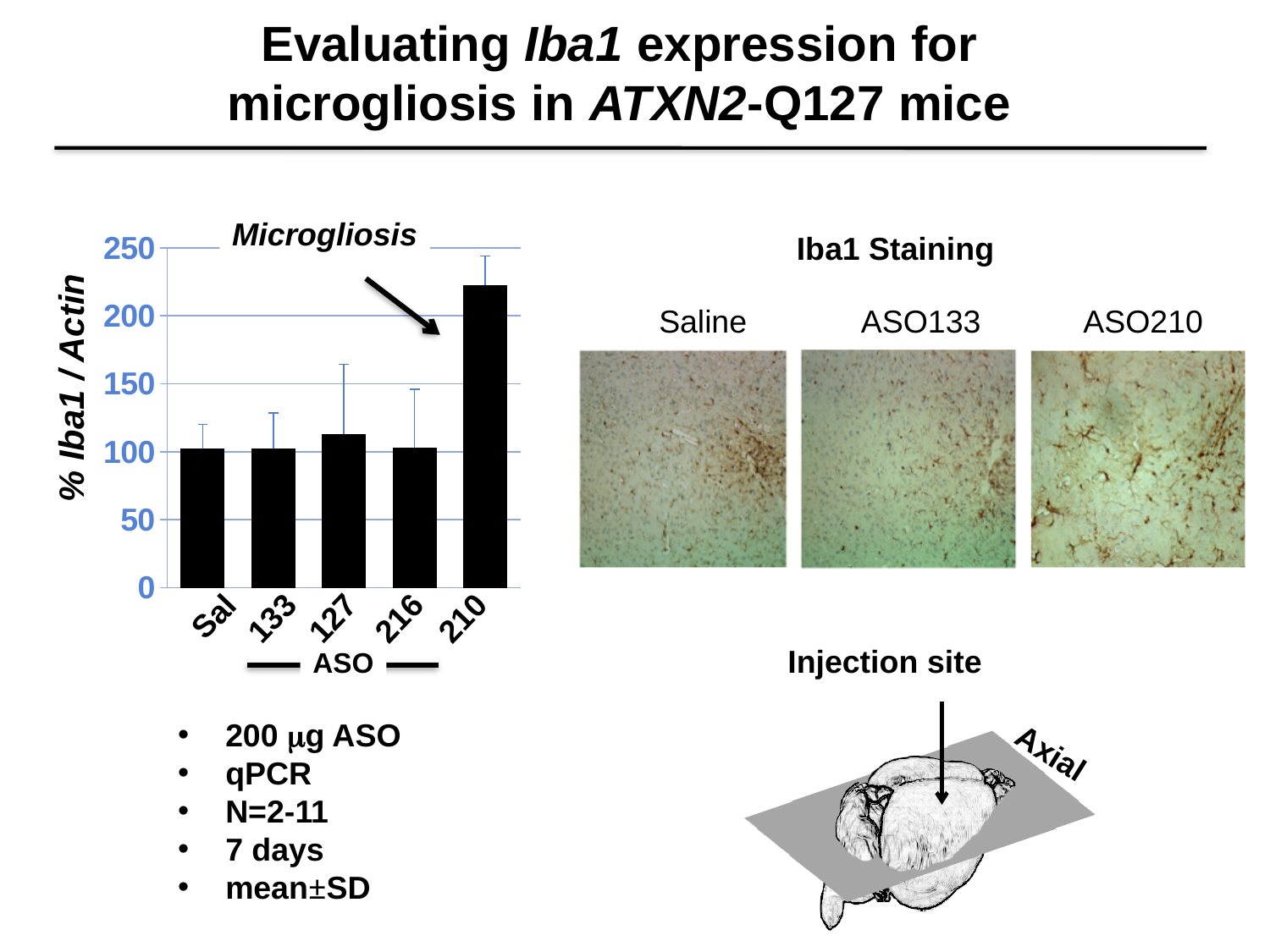
Which category has the highest value in the Microgliosis chart? 210 What kind of chart is the Microgliosis chart? bar chart Is the value for 133 in the Microgliosis chart greater or less than 50? greater What is the y-axis label of the Microgliosis chart? % Iba1 / Actin Is the value for 210 in the Microgliosis chart greater or less than 200? greater In the Microgliosis chart, which is larger, the value for Sal or the value for 210? 210 What is the maximum value shown on the y axis of the Microgliosis chart? 250 Is the value for 127 in the Microgliosis chart greater or less than 150? less How many categories are shown on the x axis of the Microgliosis chart? 5 What is the title of the bar chart on the slide? Microgliosis In the Microgliosis chart, which is larger, the value for 127 or the value for 210? 210